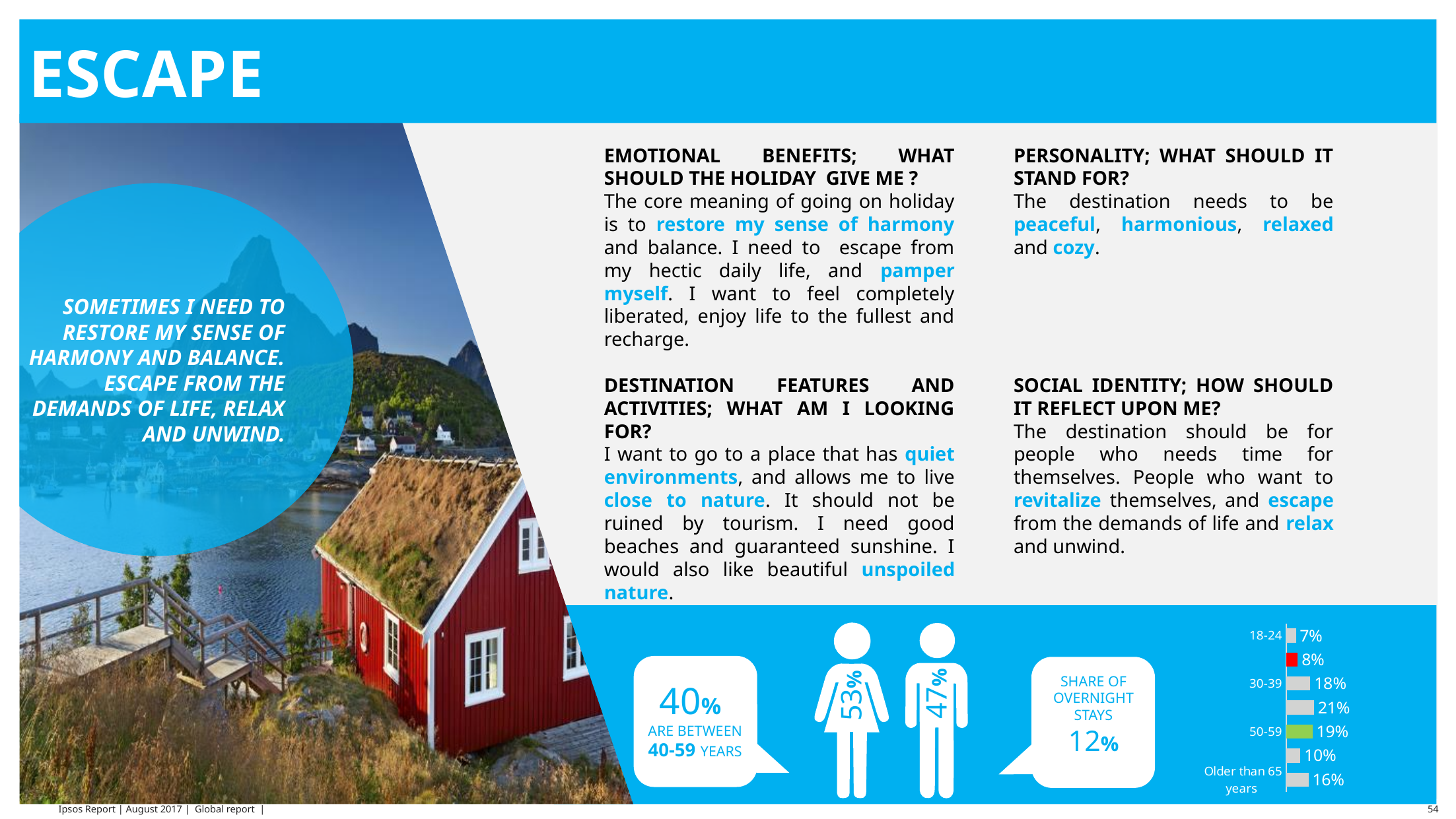
What kind of chart is shown at the bottom right of the slide? Bar chart In the age-group bar chart at the bottom right, what is the difference between the values for 50-59 and Older than 65 years? 3% In the age-group bar chart at the bottom right, which is larger, the value for 30-39 or the value for Older than 65 years? 30-39 In the age-group bar chart at the bottom right, which labelled age group has the lowest value? 18-24 In the age-group bar chart at the bottom right, what is the value for Older than 65 years? 16% In the age-group bar chart at the bottom right, what is the largest percentage shown on any bar? 21% In the age-group bar chart at the bottom right, what is the difference between the values for 30-39 and 18-24? 11% In the age-group bar chart at the bottom right, what colour is the bar for 50-59? Green In the age-group bar chart at the bottom right, how many bars are plotted? 7 In the age-group bar chart at the bottom right, what is the value for 18-24? 7% In the age-group bar chart at the bottom right, what is the value for 30-39? 18% In the age-group bar chart at the bottom right, what is the value for 50-59? 19%